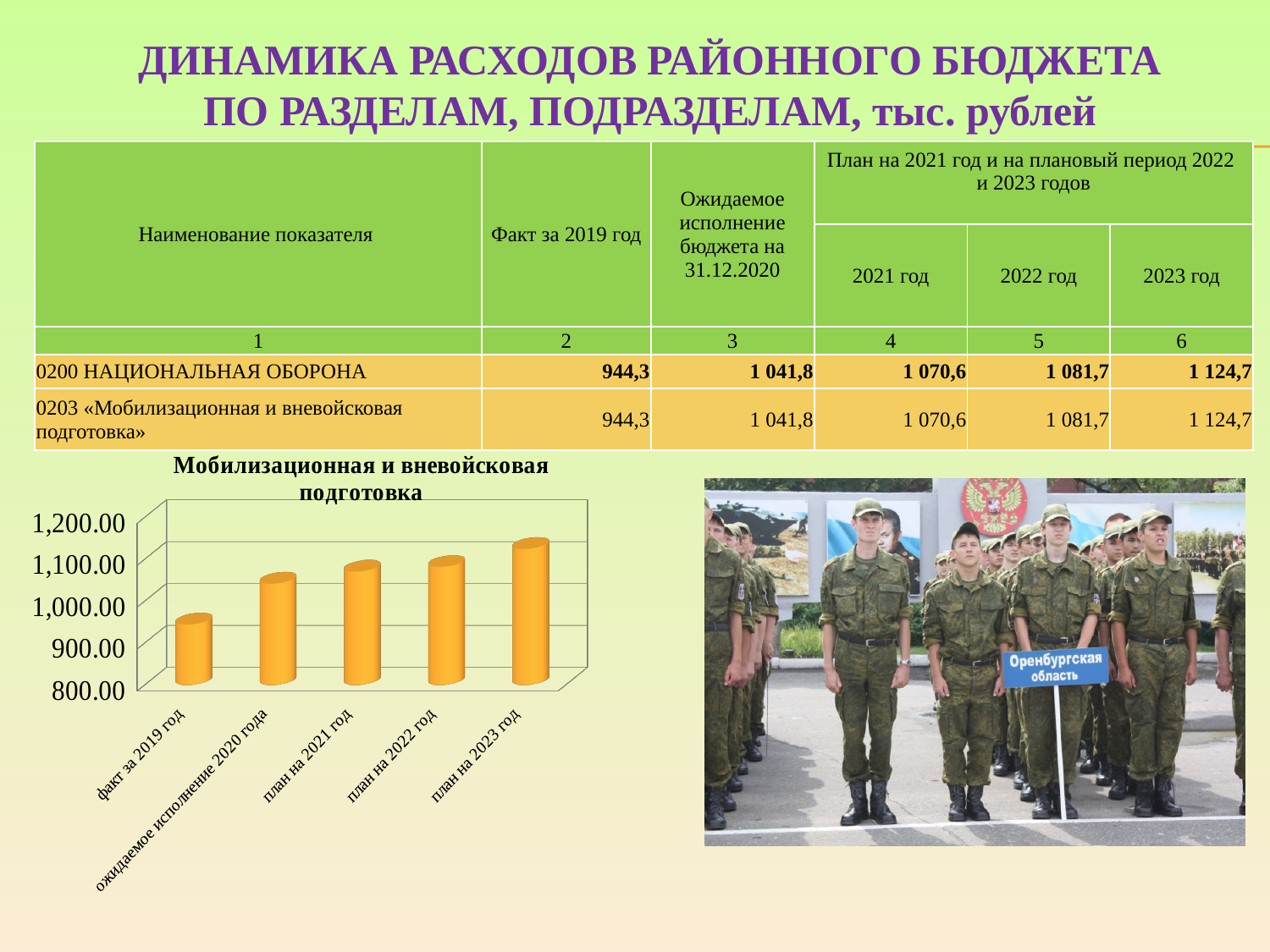
What is the title of the bar chart on the slide? Мобилизационная и вневойсковая подготовка In the «Мобилизационная и вневойсковая подготовка» chart, do the values rise or fall from «факт за 2019 год» to «план на 2023 год»? rise In the «Мобилизационная и вневойсковая подготовка» chart, is the value for «план на 2023 год» greater or less than 1,100.00? greater In the «Мобилизационная и вневойсковая подготовка» chart, is the value for «ожидаемое исполнение 2020 года» greater or less than 1,000.00? greater What is the lowest value shown on the vertical axis of the «Мобилизационная и вневойсковая подготовка» chart? 800.00 In the «Мобилизационная и вневойсковая подготовка» chart, which category has the lowest bar? факт за 2019 год In the «Мобилизационная и вневойсковая подготовка» chart, is the value for «план на 2021 год» greater or less than 1,100.00? less In the «Мобилизационная и вневойсковая подготовка» chart, which category has the highest bar? план на 2023 год What kind of chart is shown under the title «Мобилизационная и вневойсковая подготовка»? bar chart In the «Мобилизационная и вневойсковая подготовка» chart, which is larger: the bar for «факт за 2019 год» or the bar for «план на 2023 год»? план на 2023 год How many bars are plotted in the «Мобилизационная и вневойсковая подготовка» chart? 5